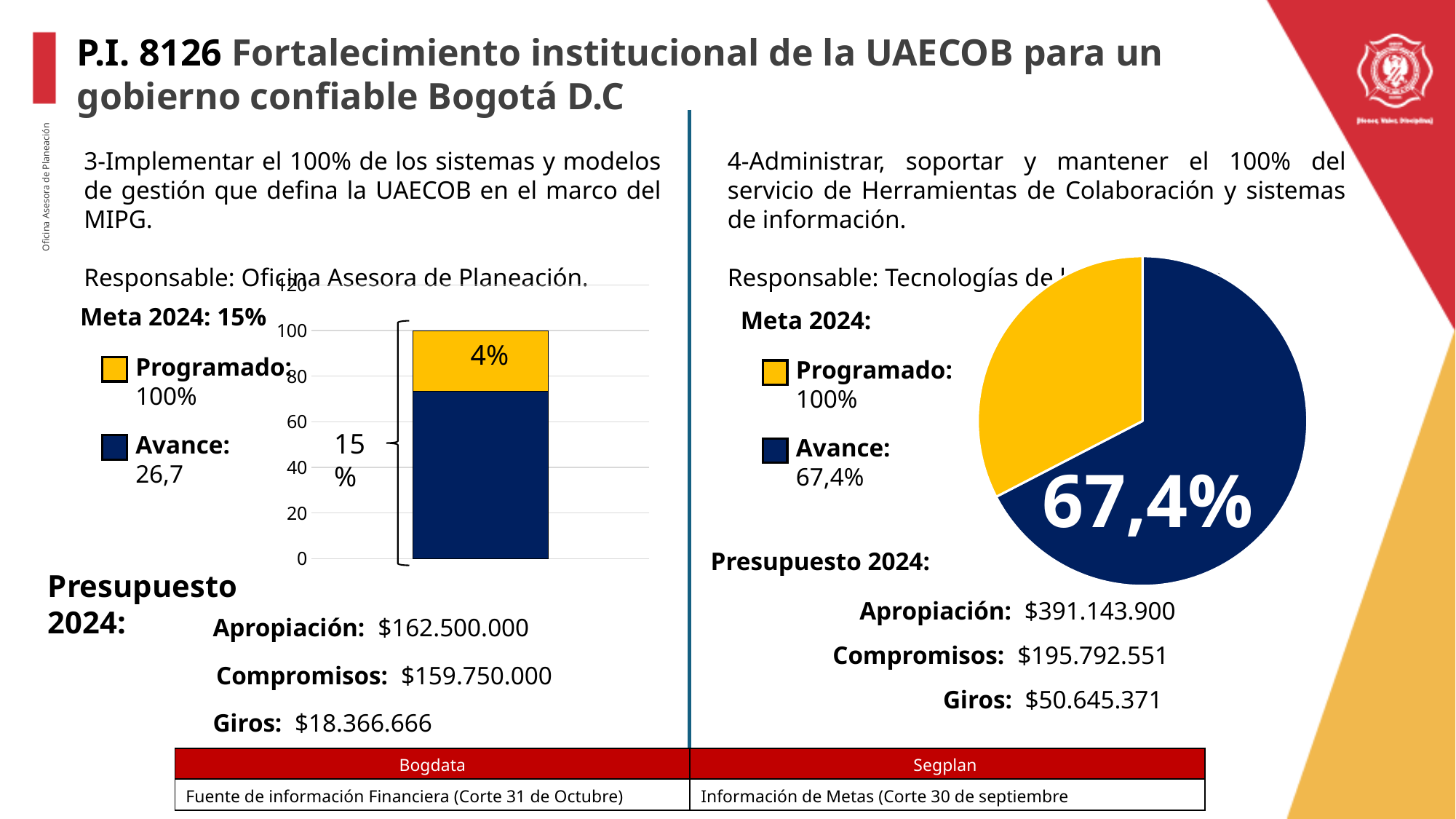
In the pie chart on the right, which slice is larger, the dark blue one or the yellow one? the dark blue one In the bar chart on the left, what data label is printed on the yellow segment of the bar? 4% In the bar chart on the left, is the top of the dark blue segment greater or less than 80? less In the bar chart on the left, what y-axis value does the top of the stacked bar reach? 100 In the legend next to the pie chart on the right, which colour represents 'Programado'? yellow What kind of chart is shown on the left side of the slide, under 'Meta 2024: 15%'? bar chart In the bar chart on the left, is the top of the dark blue segment greater or less than 60? greater In the pie chart on the right, what value is printed on the dark blue slice? 67,4% How many bars are plotted in the bar chart on the left? 1 How many slices does the pie chart on the right have? 2 What kind of chart is shown on the right side of the slide, next to 'Avance: 67,4%'? pie chart In the bar chart on the left, what is the highest value shown on the y axis? 120